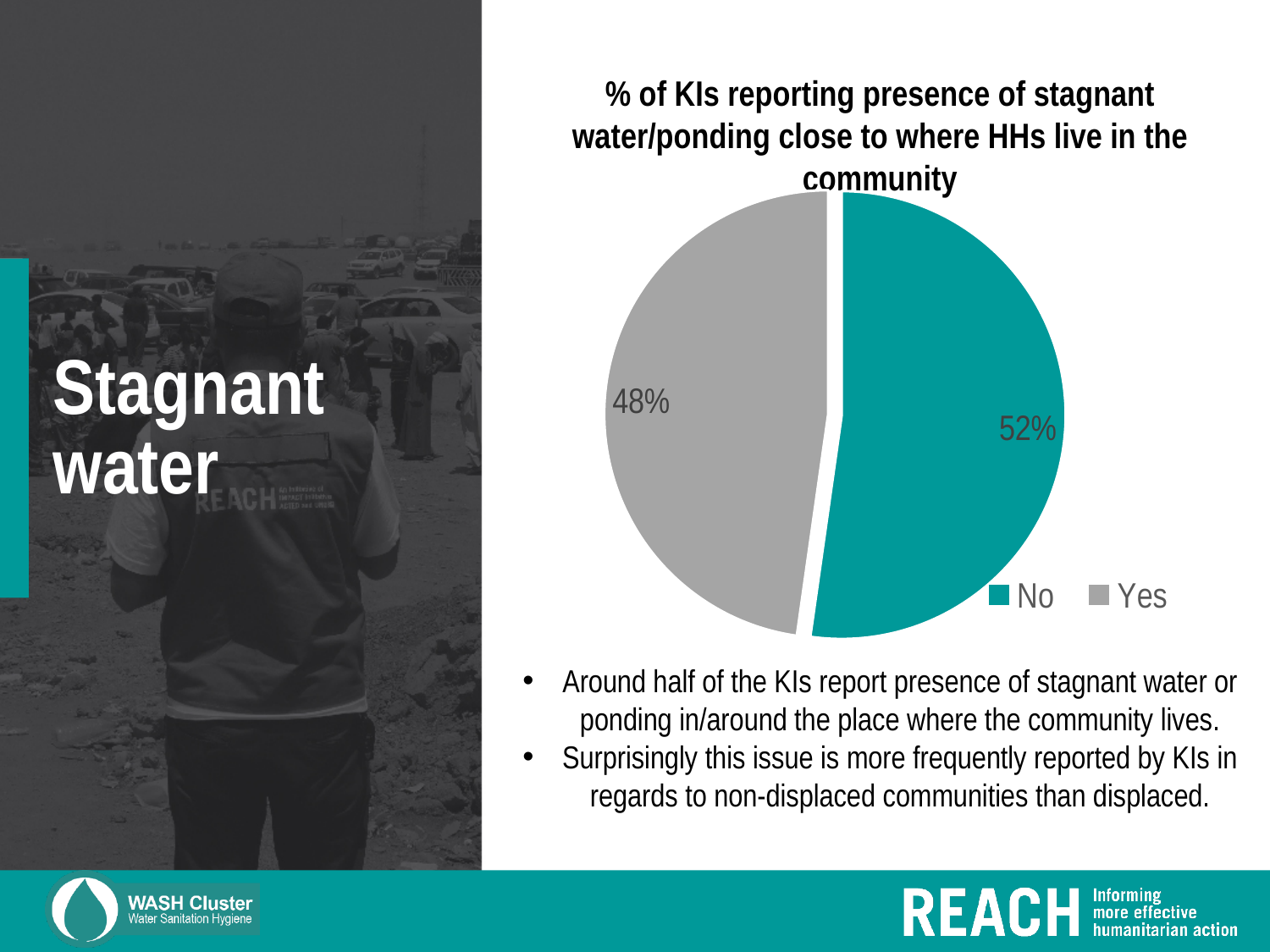
How many categories does the pie chart show? 2 Which category has the largest slice in the pie chart? No What is the difference in percentage points between the 'No' and 'Yes' slices? 4 Which category has the smallest slice in the pie chart? Yes What colour is the 'No' slice in the pie chart? Teal Which response has the larger share of the pie, 'No' or 'Yes'? No What percentage of KIs reported 'Yes' for presence of stagnant water/ponding close to where HHs live? 48% What is the title of the pie chart? % of KIs reporting presence of stagnant water/ponding close to where HHs live in the community Is the value for 'No' greater or less than 50%? greater What kind of chart is shown on the slide? Pie chart What percentage of KIs reported 'No' for presence of stagnant water/ponding close to where HHs live? 52% What share of the pie does the 'Yes' slice represent? 48%